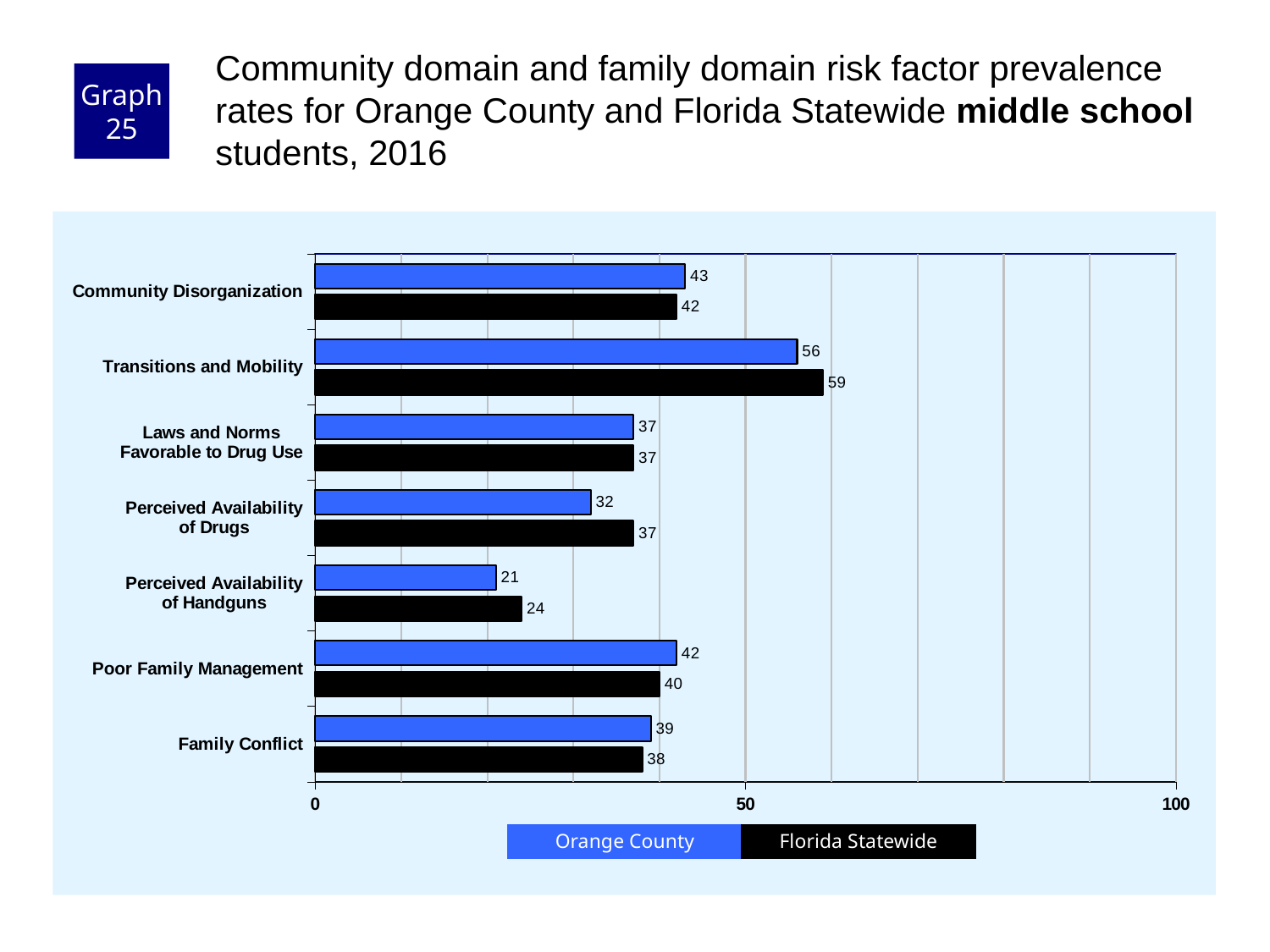
How many risk factor categories are shown on the chart? 7 For Community Disorganization, which is larger: the Orange County value or the Florida Statewide value? Orange County Is the Florida Statewide value for Transitions and Mobility greater or less than 50? greater What is the Orange County value for Poor Family Management? 42 Which colour represents Florida Statewide in the chart? black How many series does the legend list? 2 What is the Florida Statewide value for Perceived Availability of Handguns? 24 What is the Orange County value for Transitions and Mobility? 56 What kind of chart is shown on the slide? bar chart Which risk factor has the lowest Orange County value? Perceived Availability of Handguns Which risk factor has the highest Florida Statewide value? Transitions and Mobility What is the difference between the Florida Statewide and Orange County values for Perceived Availability of Drugs? 5